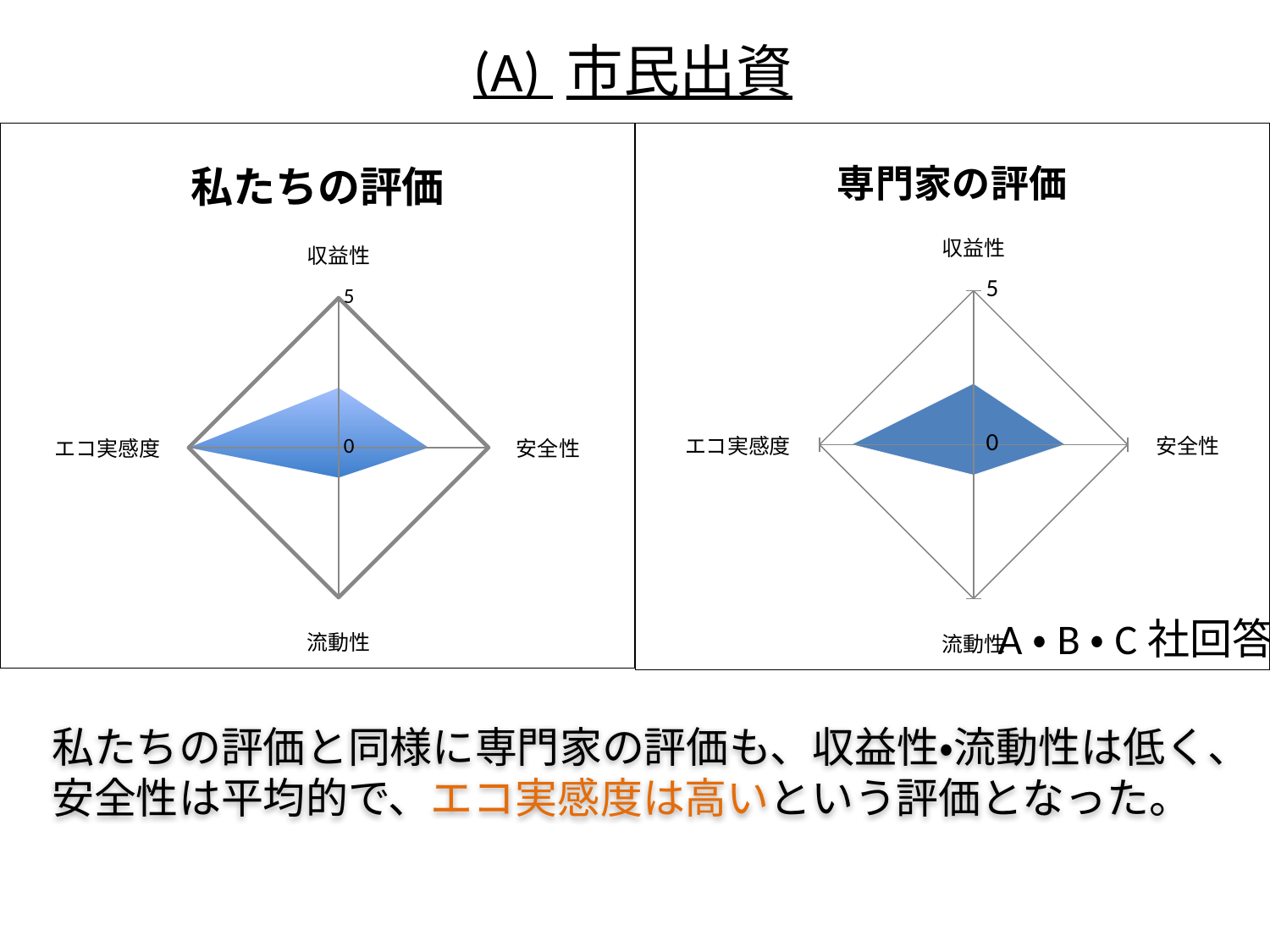
In the 専門家の評価 chart, which is larger, 安全性 or 流動性? 安全性 What is the title of the right-hand chart? 専門家の評価 In the 私たちの評価 chart, which category has the highest value? エコ実感度 How many categories (axes) does the 私たちの評価 chart have? 4 In the 私たちの評価 chart, what is the value for エコ実感度? 5 In the 専門家の評価 chart, which category has the lowest value? 流動性 What kind of chart is the left chart titled 私たちの評価? radar chart In the 私たちの評価 chart, which category has the lowest value? 流動性 In the 専門家の評価 chart, which category has the highest value? エコ実感度 In the 私たちの評価 chart, which is larger, 安全性 or 収益性? 安全性 What is the maximum value shown on the axis scale of the 専門家の評価 chart? 5 In the 専門家の評価 chart, is the value for エコ実感度 greater or less than 5? less